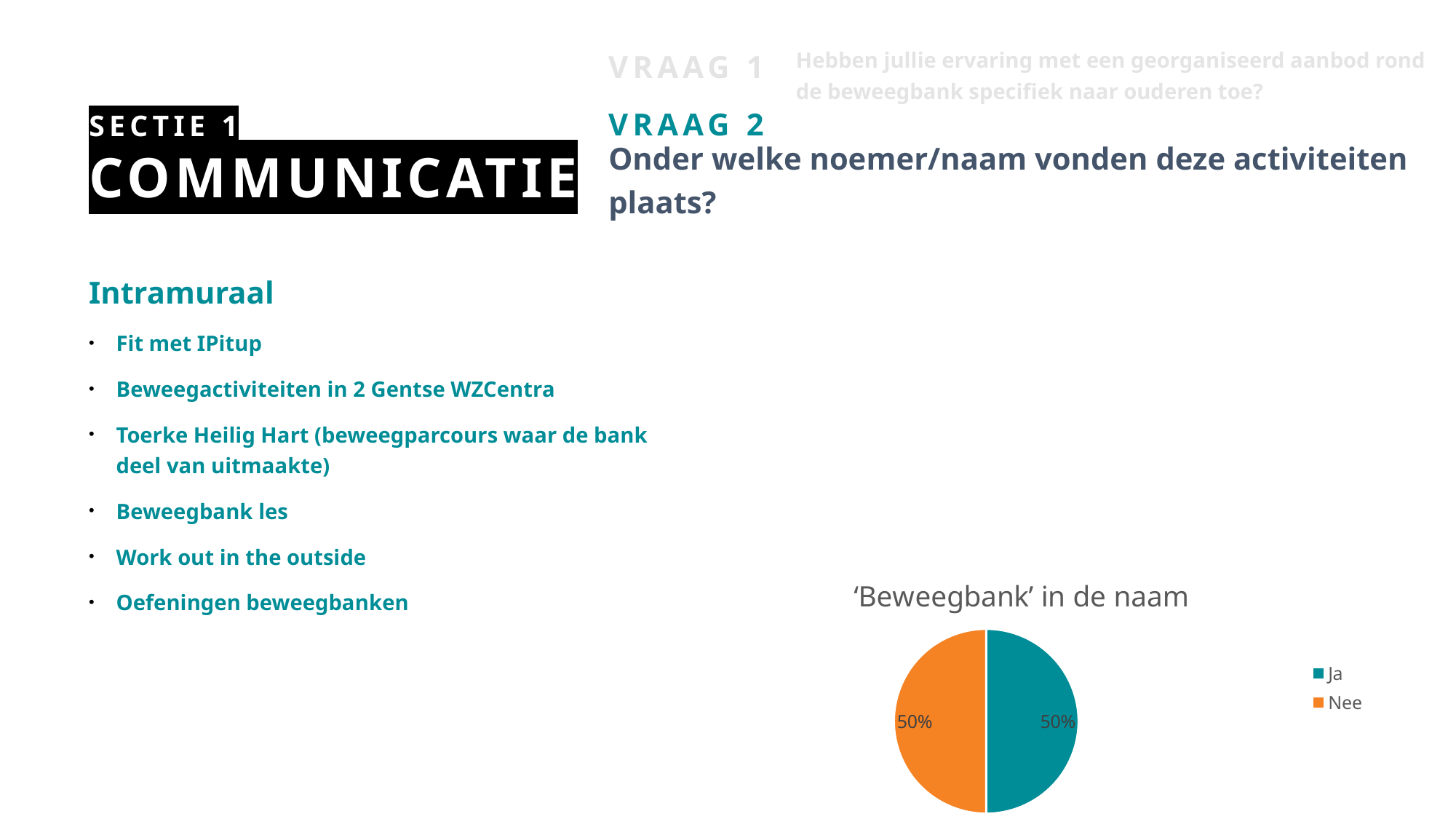
What is the difference between the 'Ja' and 'Nee' shares in the pie chart? 0% How many slices does the pie chart have? 2 How many entries does the legend of the pie chart list? 2 What is the title of the pie chart? ‘Beweegbank’ in de naam What share of the pie does 'Ja' represent? 50% Which colour represents 'Nee' in the pie chart? orange What share of the pie does 'Nee' represent? 50% What is the combined share of 'Ja' and 'Nee' in the pie chart? 100% What kind of chart is shown on the slide? pie chart